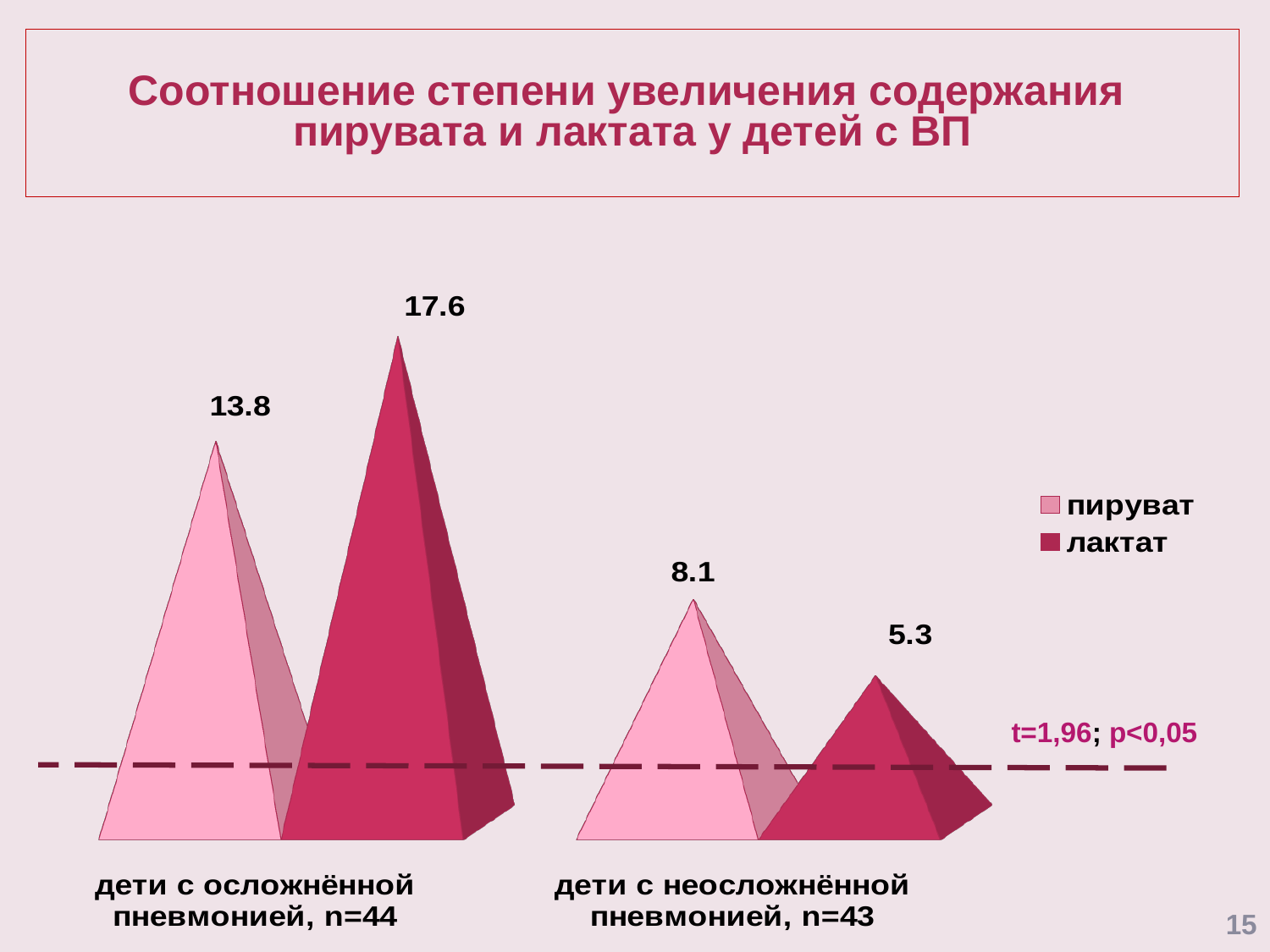
What is the value of лактат for дети с неосложнённой пневмонией, n=43? 5.3 How many series does the legend list? 2 What is the value of пируват for дети с неосложнённой пневмонией, n=43? 8.1 Which category has the highest лактат value? дети с осложнённой пневмонией, n=44 For дети с неосложнённой пневмонией, n=43, which is larger: пируват or лактат? пируват How many categories are shown on the x axis? 2 Which series has the lowest value for дети с неосложнённой пневмонией, n=43? лактат What is the value of лактат for дети с осложнённой пневмонией, n=44? 17.6 What is the difference between the лактат and пируват values for дети с осложнённой пневмонией, n=44? 3.8 What is the difference between the пируват values for the two categories? 5.7 What is the value of пируват for дети с осложнённой пневмонией, n=44? 13.8 What kind of chart is shown on the slide? bar chart